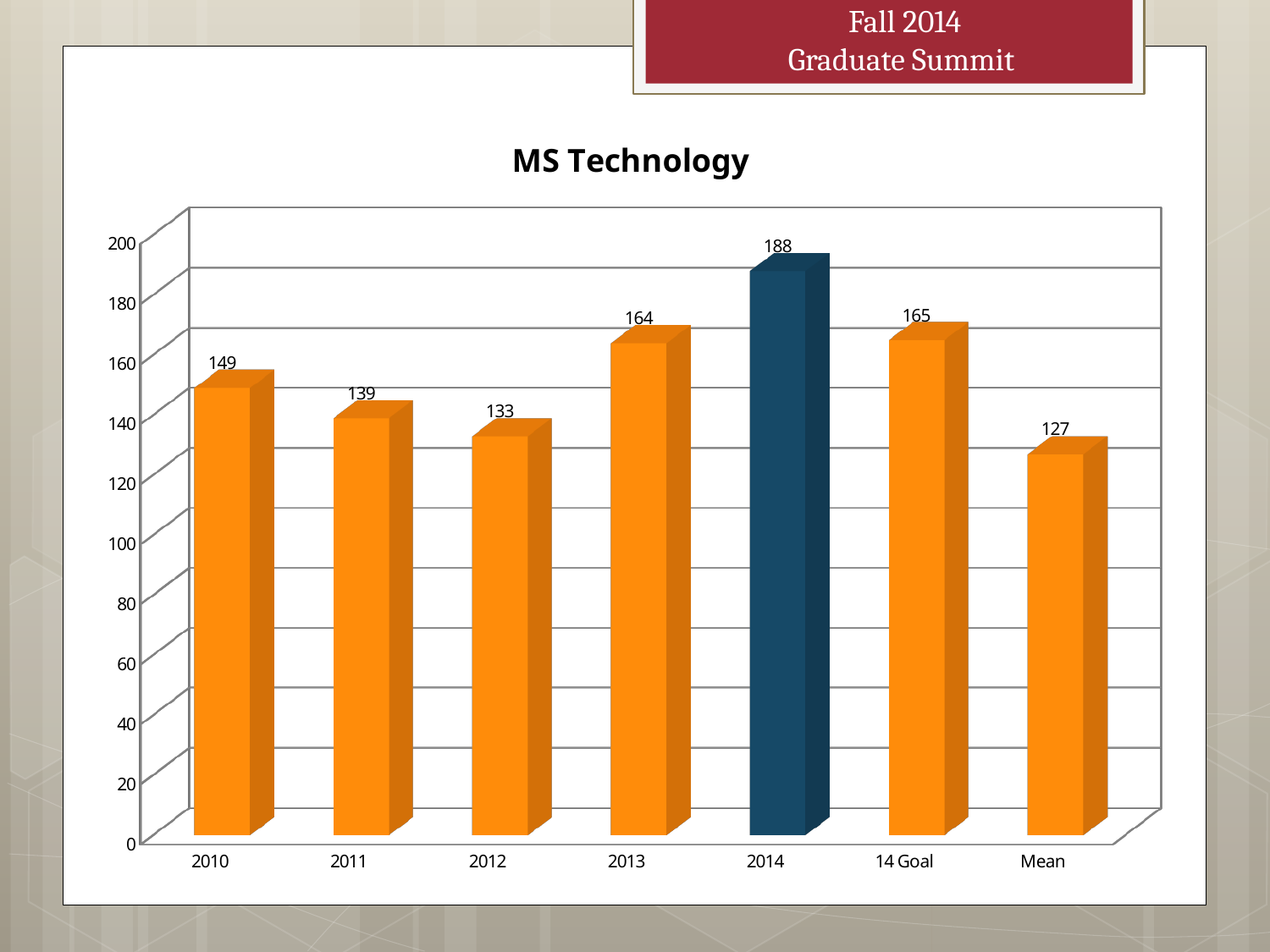
Is the value for 2013 greater or less than 160 in the MS Technology chart? greater Which category has the lowest value in the MS Technology chart? Mean Which category has the highest value in the MS Technology chart? 2014 What kind of chart is shown on the slide? bar chart How many categories are shown on the x axis of the MS Technology chart? 7 What is the value for 2012 in the MS Technology chart? 133 Which bar in the MS Technology chart is coloured differently from the others? 2014 What is the value for 14 Goal in the MS Technology chart? 165 Which is larger in the MS Technology chart, the value for 2010 or the value for 2011? 2010 What is the difference between the 2013 value and the 2012 value in the MS Technology chart? 31 What is the difference between the 2014 value and the 14 Goal value in the MS Technology chart? 23 What is the value for 2014 in the MS Technology chart? 188